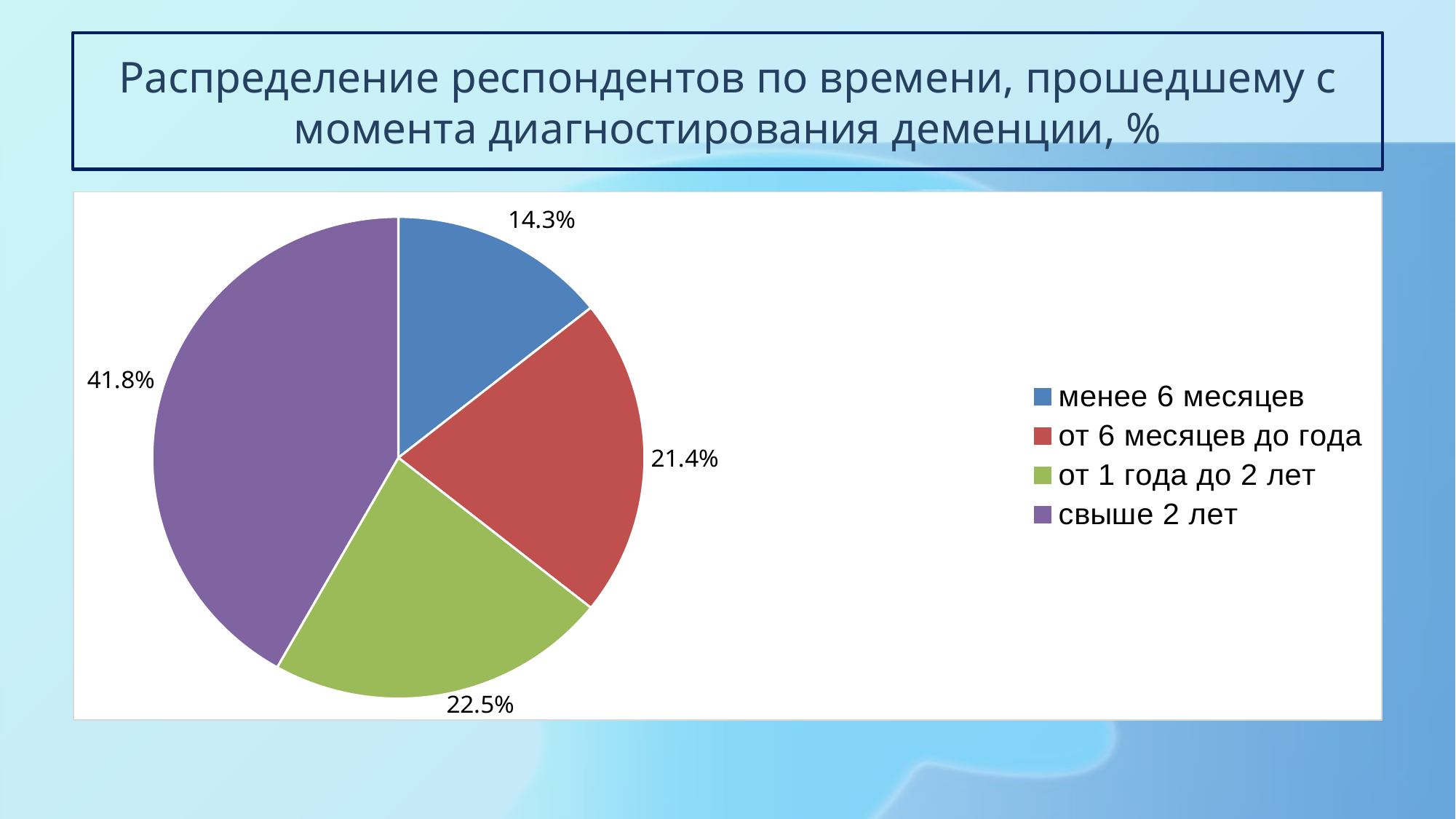
What share of respondents falls in the 'от 1 года до 2 лет' category? 22.5% How many categories does the pie chart show? 4 Which is larger: the share for 'от 1 года до 2 лет' or for 'от 6 месяцев до года'? от 1 года до 2 лет What share of respondents falls in the 'свыше 2 лет' category? 41.8% Which category has the largest share of respondents? свыше 2 лет What colour is the slice for 'свыше 2 лет'? purple What type of chart is shown on the slide? pie chart What share of respondents falls in the 'от 6 месяцев до года' category? 21.4% What share of respondents falls in the 'менее 6 месяцев' category? 14.3% What is the title of the chart? Распределение респондентов по времени, прошедшему с момента диагностирования деменции, % Which category has the smallest share of respondents? менее 6 месяцев What is the difference in percentage points between 'свыше 2 лет' and 'менее 6 месяцев'? 27.5